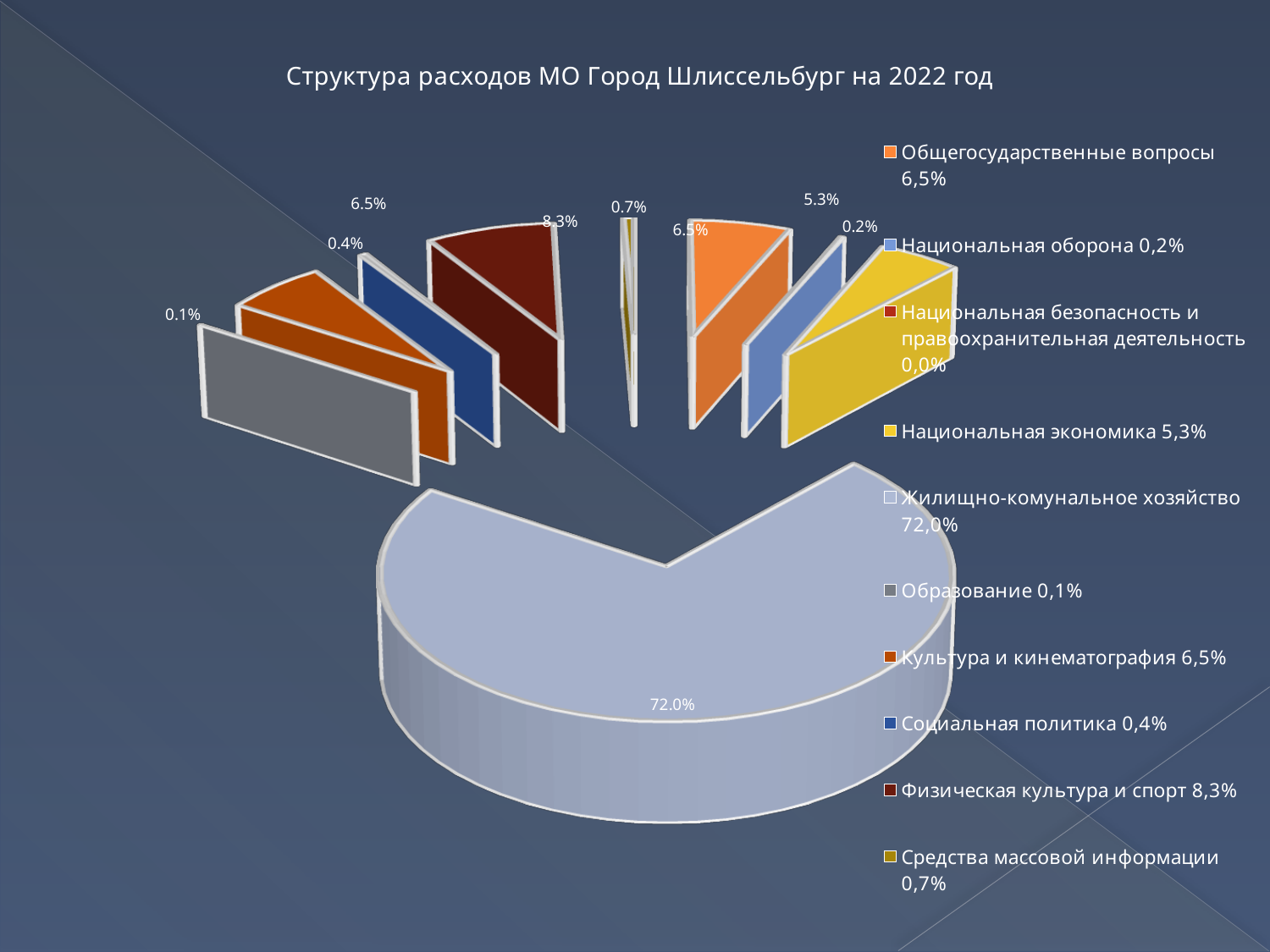
Which category has the largest share of the pie? Жилищно-комунальное хозяйство What is the value for Средства массовой информации? 0.7% What is the value for Национальная экономика? 5.3% What is the title of the chart? Структура расходов МО Город Шлиссельбург на 2022 год Which category has the smallest value according to the legend? Национальная безопасность и правоохранительная деятельность Which is larger, Физическая культура и спорт or Национальная экономика? Физическая культура и спорт What is the value for Физическая культура и спорт? 8.3% What is the difference between Физическая культура и спорт and Культура и кинематография? 1.8% What share of the pie does Жилищно-комунальное хозяйство have? 72.0% What is the value for Социальная политика? 0.4% What kind of chart is shown on the slide? pie chart How many entries does the legend list? 10